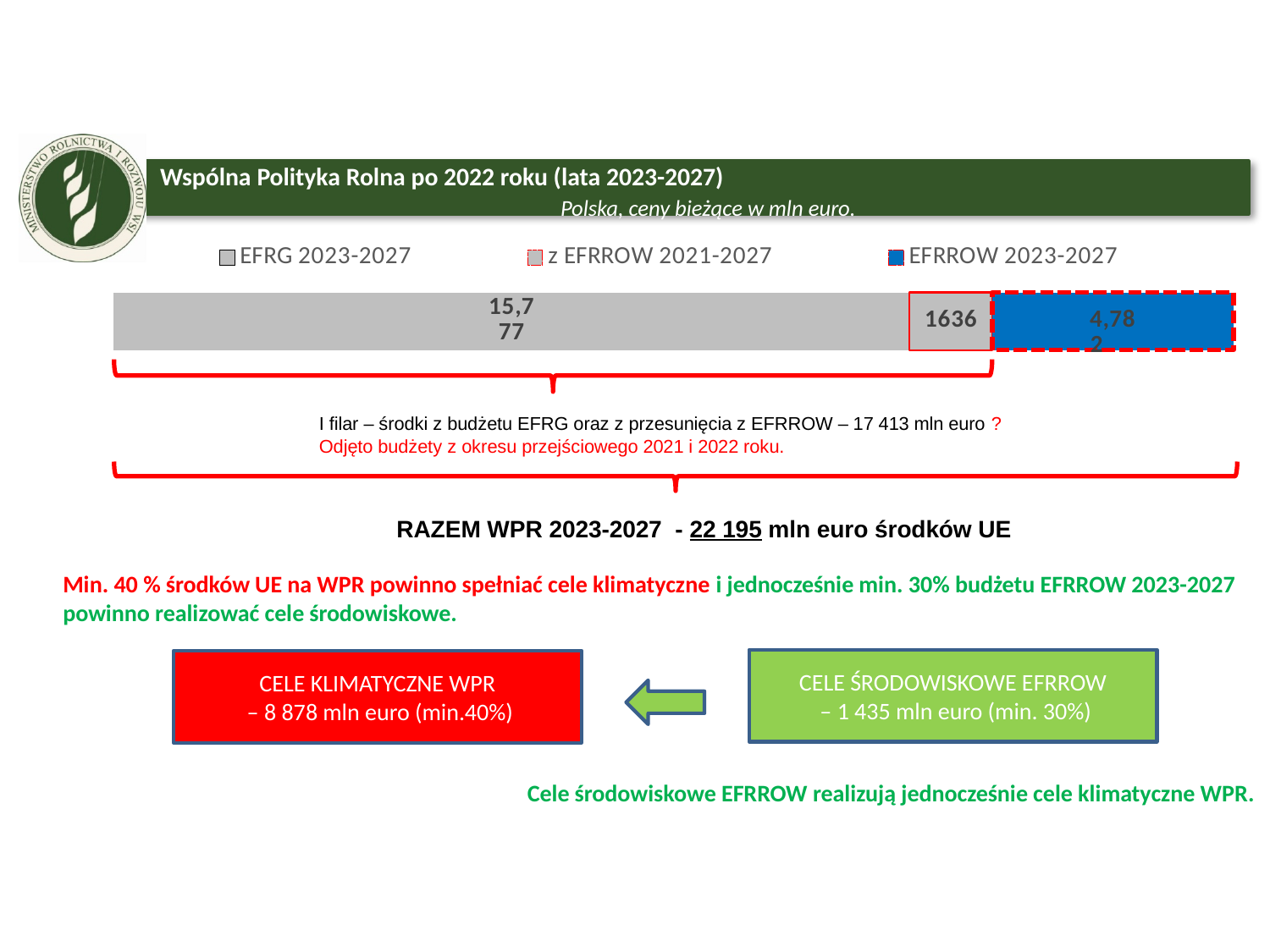
What is the title of the chart? Wspólna Polityka Rolna po 2022 roku (lata 2023-2027) Which series has the smallest segment in the bar? z EFRROW 2021-2027 What is the total of the stacked bar (RAZEM WPR 2023-2027), in mln euro? 22 195 How many series does the chart legend list? 3 What colour is the EFRROW 2023-2027 segment of the bar? blue What is the difference between the EFRROW 2023-2027 segment and the z EFRROW 2021-2027 segment? 3146 Which series has the largest segment in the bar? EFRG 2023-2027 What kind of chart is shown on the slide? bar chart What is the value of the z EFRROW 2021-2027 segment in the bar? 1636 What is the value of the EFRROW 2023-2027 segment in the bar? 4,782 What is the value of the EFRG 2023-2027 segment in the bar? 15,777 Which is larger, the EFRG 2023-2027 segment or the EFRROW 2023-2027 segment? EFRG 2023-2027